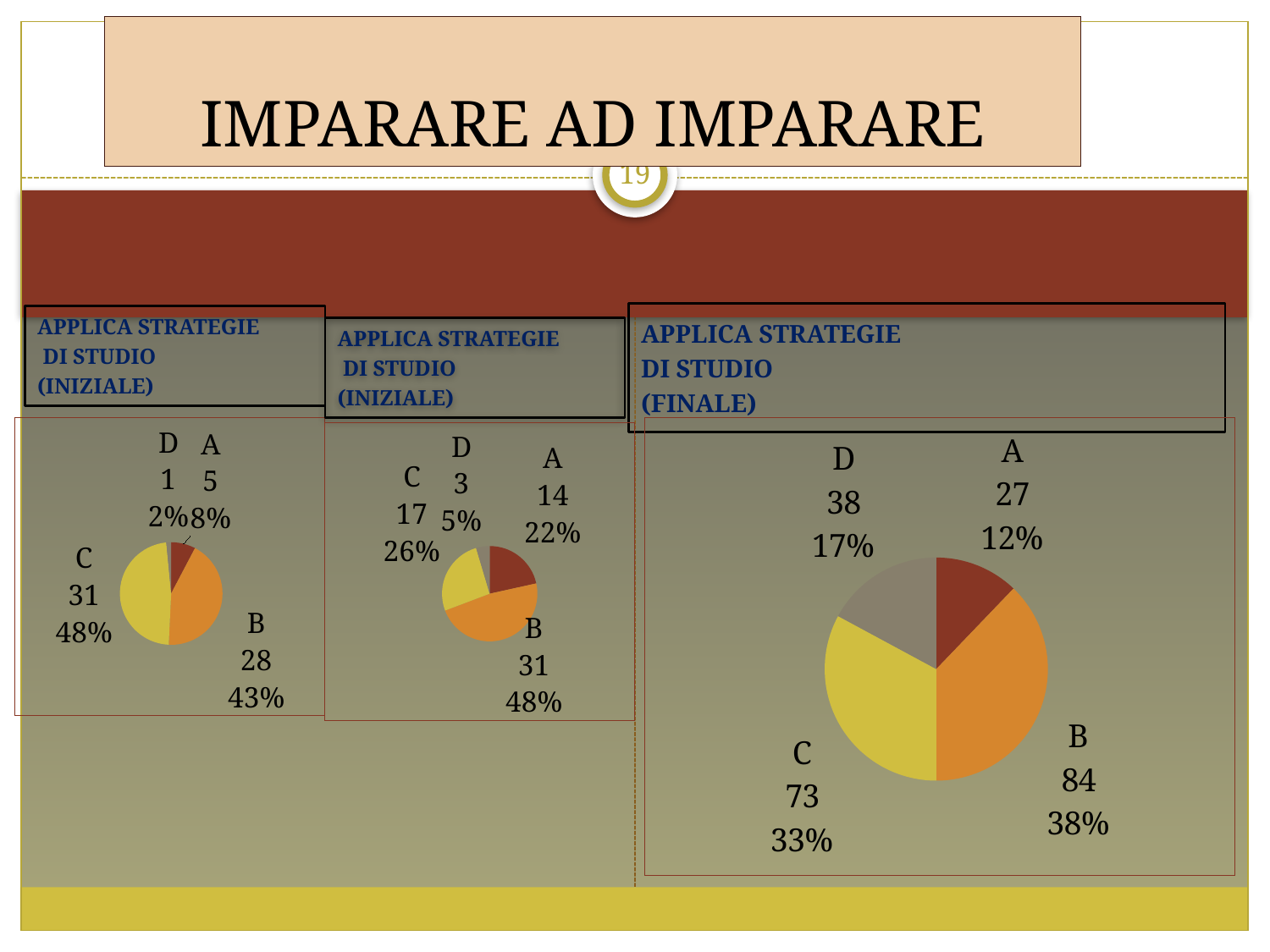
In the rightmost chart (FINALE), which category has the smallest value? A In the leftmost chart (INIZIALE), what share of the pie does category D represent? 2% In the rightmost chart (FINALE), what is the difference between the values for B and C? 11 What kind of chart is the rightmost chart, titled 'APPLICA STRATEGIE DI STUDIO (FINALE)'? pie chart In the leftmost chart (INIZIALE), what is the value for category C? 31 How many categories does the middle chart (INIZIALE) show? 4 In the rightmost chart (FINALE), what share of the pie does category D represent? 17% In the leftmost chart (INIZIALE), which category has the smallest value? D In the middle chart (INIZIALE), what is the value for category A? 14 In the middle chart (INIZIALE), which is larger, the value for C or the value for A? C In the rightmost chart (FINALE), which category has the largest value? B In the rightmost chart (FINALE), what is the value for category B? 84